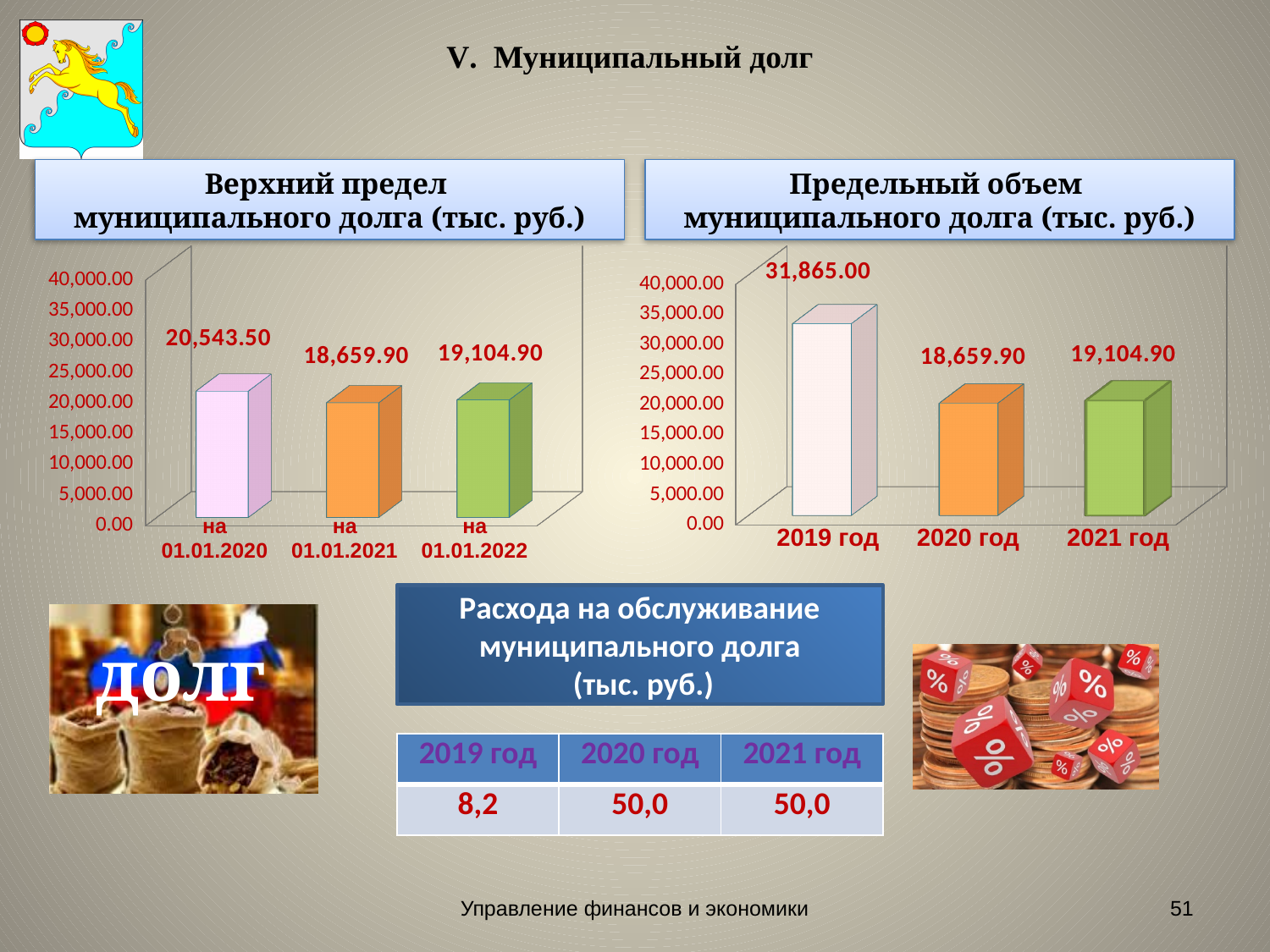
In the chart 'Предельный объем муниципального долга (тыс. руб.)', what is the value for '2019 год'? 31,865.00 How many categories are shown in the chart 'Предельный объем муниципального долга (тыс. руб.)'? 3 In the chart 'Верхний предел муниципального долга (тыс. руб.)', what is the value for 'на 01.01.2021'? 18,659.90 What kind of chart is 'Верхний предел муниципального долга (тыс. руб.)'? bar chart In the chart 'Верхний предел муниципального долга (тыс. руб.)', which category has the lowest value? на 01.01.2021 In the chart 'Предельный объем муниципального долга (тыс. руб.)', is the value for '2019 год' greater or less than 30,000.00? greater In the chart 'Верхний предел муниципального долга (тыс. руб.)', which category has the highest value? на 01.01.2020 In the chart 'Предельный объем муниципального долга (тыс. руб.)', what is the value for '2021 год'? 19,104.90 In the chart 'Предельный объем муниципального долга (тыс. руб.)', which year has the highest value? 2019 год In the chart 'Верхний предел муниципального долга (тыс. руб.)', what is the value for 'на 01.01.2020'? 20,543.50 In the chart 'Предельный объем муниципального долга (тыс. руб.)', what is the difference between the values for '2019 год' and '2020 год'? 13,205.10 In the chart 'Верхний предел муниципального долга (тыс. руб.)', what is the difference between the values for 'на 01.01.2020' and 'на 01.01.2021'? 1,883.60